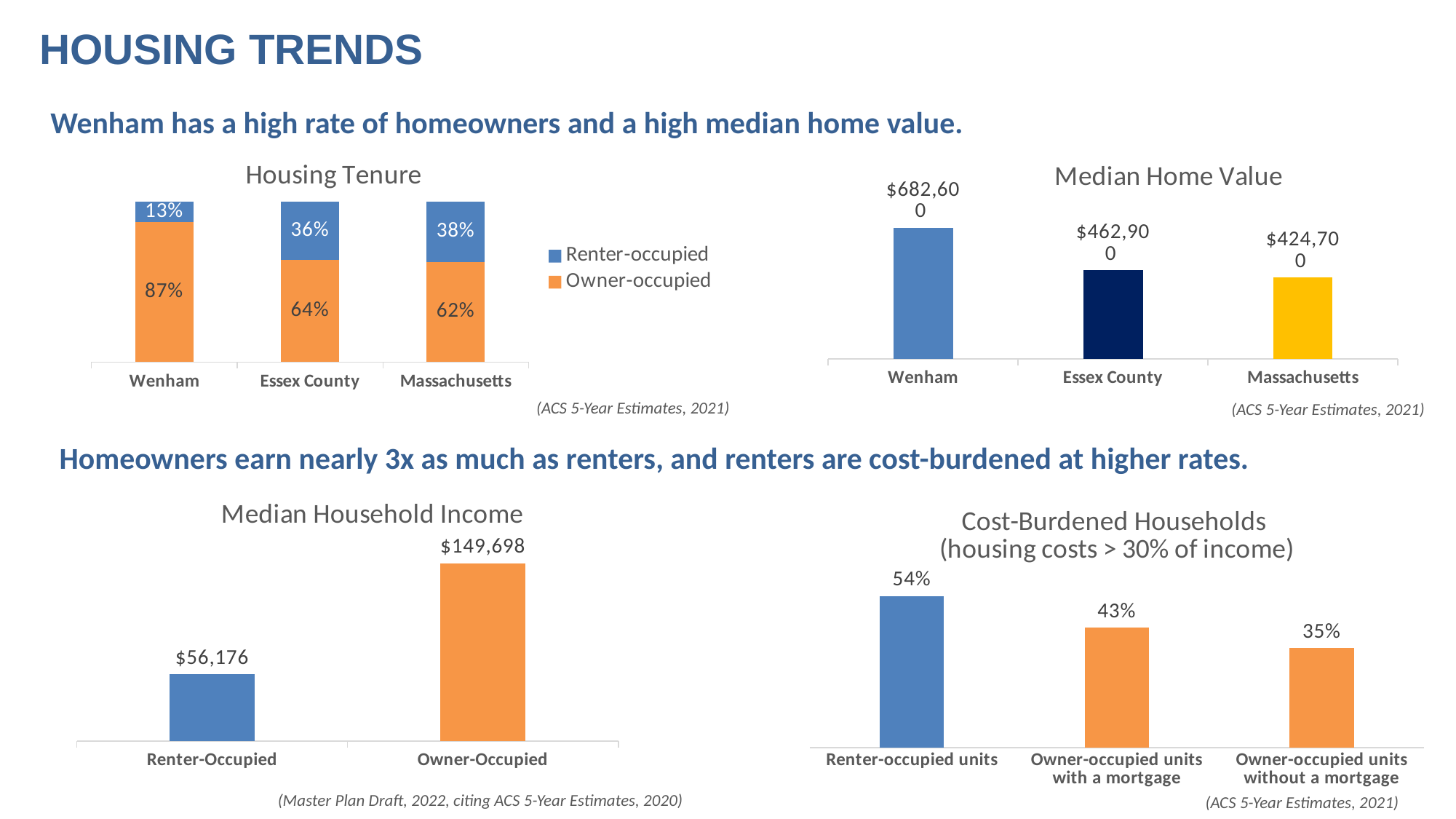
In the Housing Tenure chart, what percentage of Massachusetts housing is renter-occupied? 38% In the Median Household Income chart, what is the median household income for renter-occupied households? $56,176 What kind of chart is the Cost-Burdened Households chart? Bar chart In the Median Home Value chart, what is the difference between the median home values of Wenham and Massachusetts? $257,900 In the Housing Tenure chart, what percentage of Wenham housing is owner-occupied? 87% In the Housing Tenure chart, how many series does the legend list? 2 In the Cost-Burdened Households chart, how many categories are shown? 3 In the Cost-Burdened Households chart, what percentage of owner-occupied units with a mortgage are cost-burdened? 43% In the Median Household Income chart, what is the difference between owner-occupied and renter-occupied median household income? $93,522 In the Median Home Value chart, which area has the highest median home value? Wenham In the Median Home Value chart, what is the median home value for Essex County? $462,900 In the Housing Tenure chart, which area has the lowest renter-occupied share? Wenham